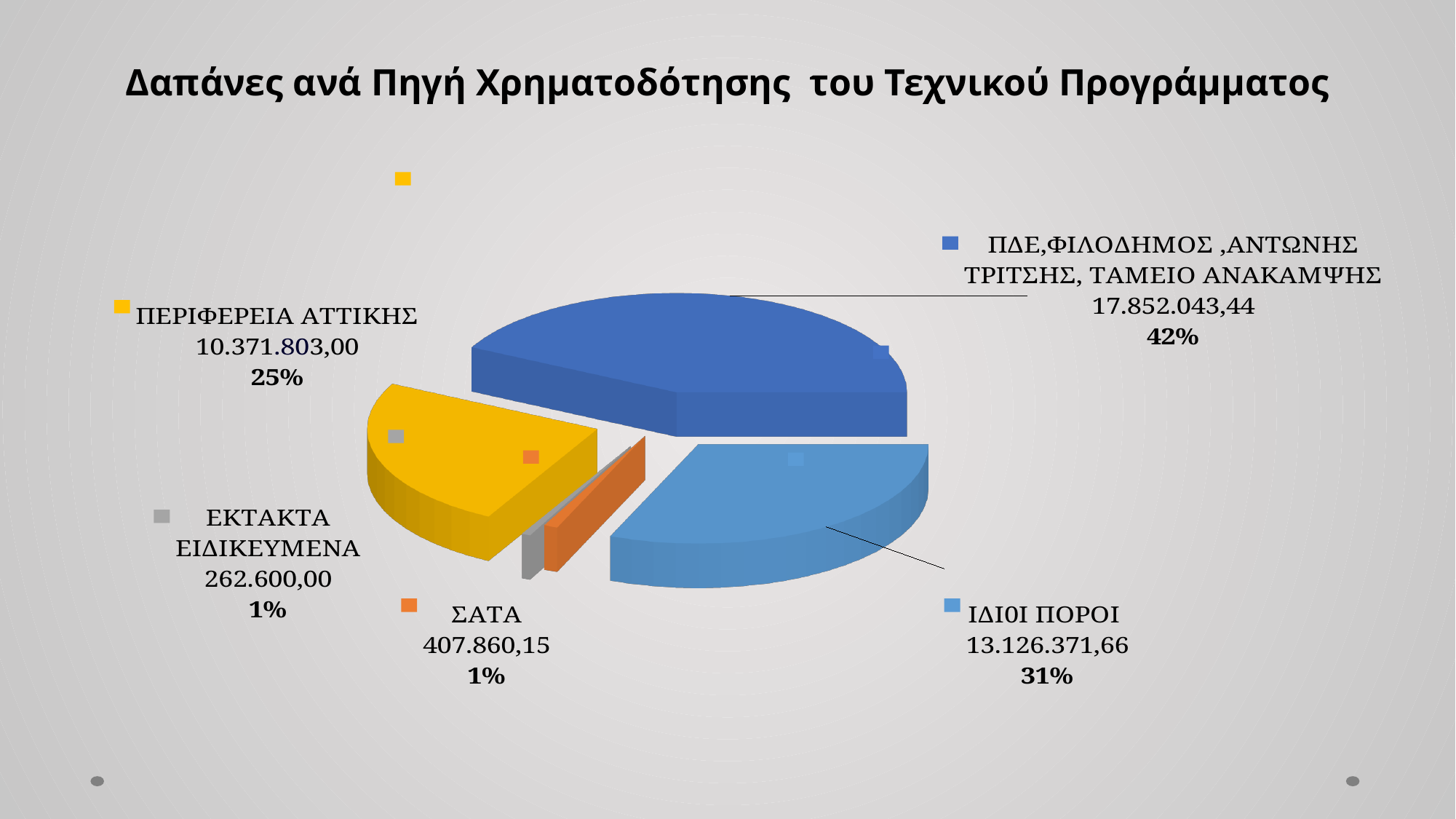
What share of the pie does ΠΔΕ,ΦΙΛΟΔΗΜΟΣ ,ΑΝΤΩΝΗΣ ΤΡΙΤΣΗΣ, ΤΑΜΕΙΟ ΑΝΑΚΑΜΨΗΣ represent? 42% What share of the pie does ΕΚΤΑΚΤΑ ΕΙΔΙΚΕΥΜΕΝΑ represent? 1% What is the value for ΣΑΤΑ? 407.860,15 Which funding source has the highest value? ΠΔΕ,ΦΙΛΟΔΗΜΟΣ ,ΑΝΤΩΝΗΣ ΤΡΙΤΣΗΣ, ΤΑΜΕΙΟ ΑΝΑΚΑΜΨΗΣ Which funding source has the lowest value? ΕΚΤΑΚΤΑ ΕΙΔΙΚΕΥΜΕΝΑ What is the value for ΠΕΡΙΦΕΡΕΙΑ ΑΤΤΙΚΗΣ? 10.371.803,00 What is the value for ΙΔΙΟΙ ΠΟΡΟΙ? 13.126.371,66 What is the difference between the values for ΣΑΤΑ and ΕΚΤΑΚΤΑ ΕΙΔΙΚΕΥΜΕΝΑ? 145.260,15 How many slices does the pie chart have? 5 What is the difference between the values for ΠΔΕ,ΦΙΛΟΔΗΜΟΣ ,ΑΝΤΩΝΗΣ ΤΡΙΤΣΗΣ, ΤΑΜΕΙΟ ΑΝΑΚΑΜΨΗΣ and ΙΔΙΟΙ ΠΟΡΟΙ? 4.725.671,78 Which is larger, the value for ΙΔΙΟΙ ΠΟΡΟΙ or the value for ΠΕΡΙΦΕΡΕΙΑ ΑΤΤΙΚΗΣ? ΙΔΙΟΙ ΠΟΡΟΙ What type of chart is shown on the slide? Pie chart